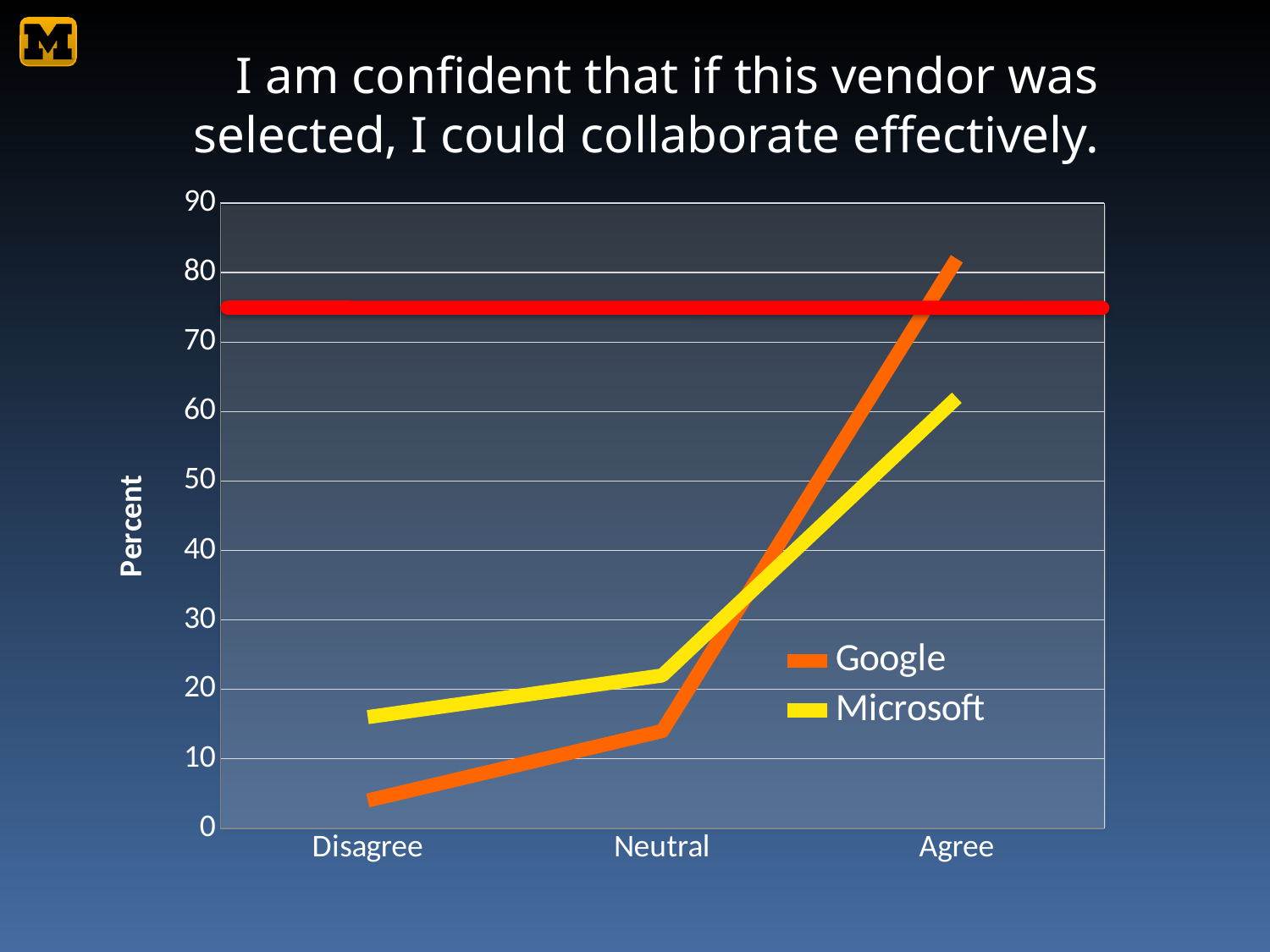
What kind of chart is shown on the slide? line chart Which series has the larger value for Agree, Google or Microsoft? Google How many categories are shown on the x axis? 3 Which category has the lowest value for Microsoft? Disagree Which series has the larger value for Disagree, Google or Microsoft? Microsoft Which category has the highest value for Google? Agree What is the label on the y axis? Percent How many series does the legend list? 2 Is the value for Microsoft at Agree greater or less than 70? less Is the value for Google at Disagree greater or less than 10? less Do the values for Google rise or fall from Disagree to Agree? rise